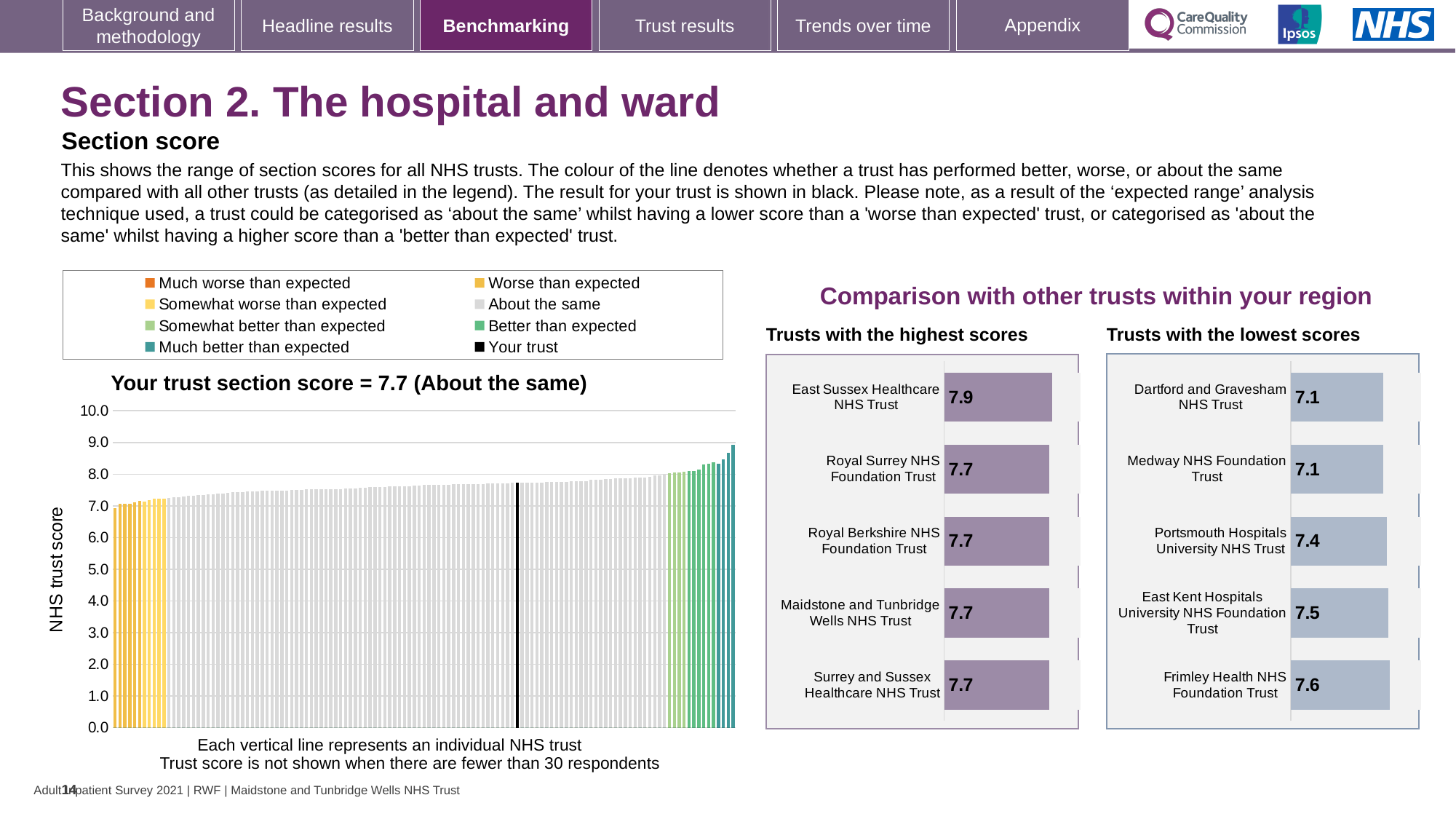
In the 'Trusts with the lowest scores' chart, which trust has the highest score? Frimley Health NHS Foundation Trust In the 'Trusts with the lowest scores' chart, what is the score for Portsmouth Hospitals University NHS Trust? 7.4 In the 'Trusts with the lowest scores' chart, which has the larger score: Portsmouth Hospitals University NHS Trust or East Kent Hospitals University NHS Foundation Trust? East Kent Hospitals University NHS Foundation Trust In the main chart titled 'Your trust section score', what is the section score for your trust? 7.7 How many entries does the legend above the main chart list? 8 In the 'Trusts with the highest scores' chart, what is the score for East Sussex Healthcare NHS Trust? 7.9 In the 'Trusts with the lowest scores' chart, what is the difference between the scores of Frimley Health NHS Foundation Trust and Dartford and Gravesham NHS Trust? 0.5 In the main chart titled 'Your trust section score', is the value of the tallest bar greater or less than 8.0? greater In the 'Trusts with the highest scores' chart, which trust has the highest score? East Sussex Healthcare NHS Trust How many trusts are listed in the 'Trusts with the highest scores' chart? 5 In the 'Trusts with the highest scores' chart, what is the difference between the scores of East Sussex Healthcare NHS Trust and Maidstone and Tunbridge Wells NHS Trust? 0.2 In the main chart titled 'Your trust section score', do the bar values rise or fall from left to right along the x axis? rise